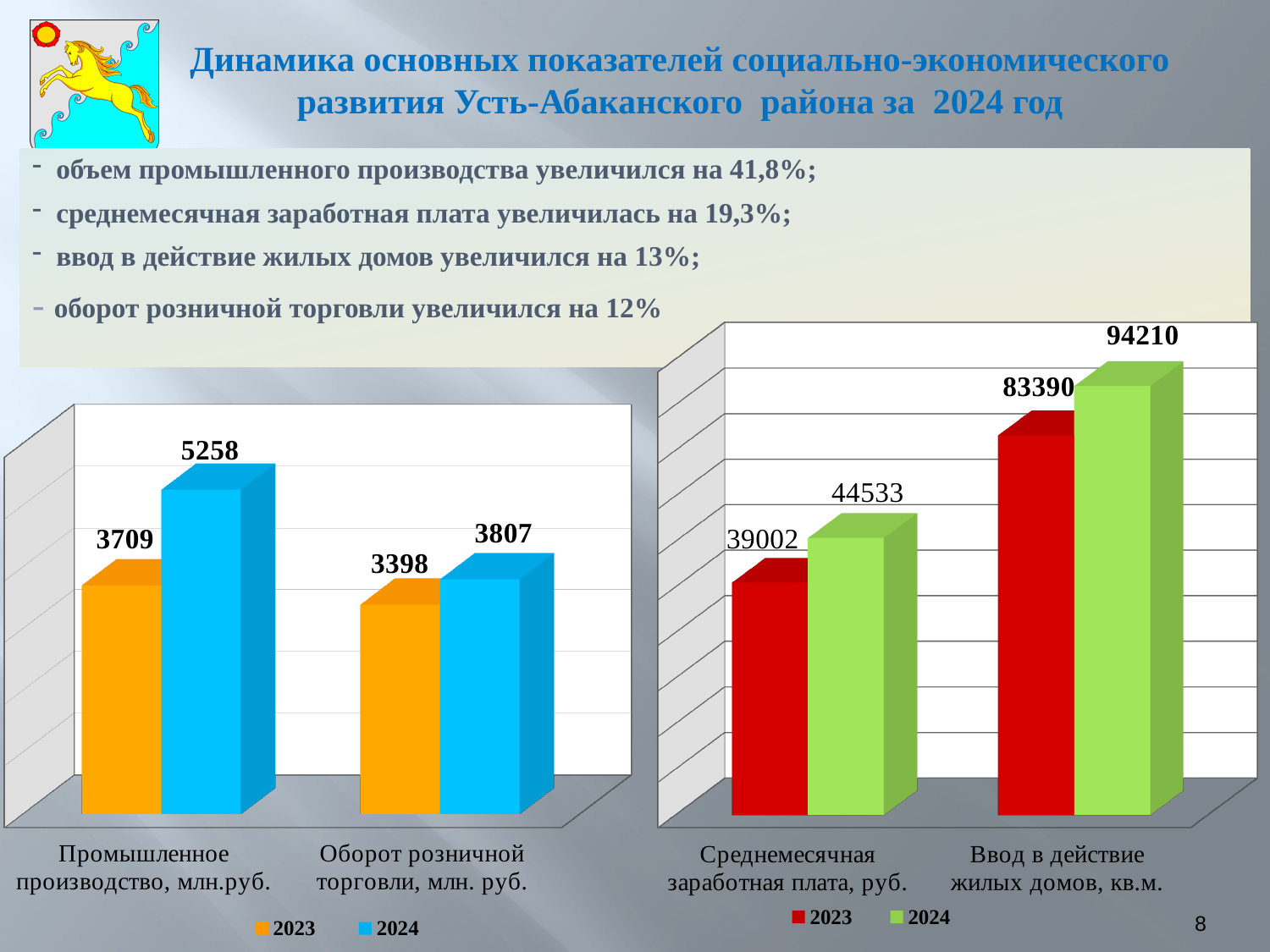
In the left chart, what is the 2023 value for Оборот розничной торговли, млн. руб.? 3398 How many series does the legend of the right chart list? 2 In the left chart, what is the 2024 value for Промышленное производство, млн.руб.? 5258 What type of chart is the right chart? Bar chart How many categories are shown in the left chart? 2 In the left chart, which bar is the lowest? Оборот розничной торговли, 2023 In the right chart, what is the 2023 value for Среднемесячная заработная плата, руб.? 39002 In the right chart, which bar is the highest? Ввод в действие жилых домов, 2024 In the right chart, what is the difference between the 2024 and 2023 values for Среднемесячная заработная плата, руб.? 5531 In the left chart, what is the difference between the 2024 and 2023 values for Промышленное производство, млн.руб.? 1549 In the left chart, which is larger: the 2024 value for Промышленное производство or the 2024 value for Оборот розничной торговли? Промышленное производство In the right chart, what is the 2024 value for Ввод в действие жилых домов, кв.м.? 94210